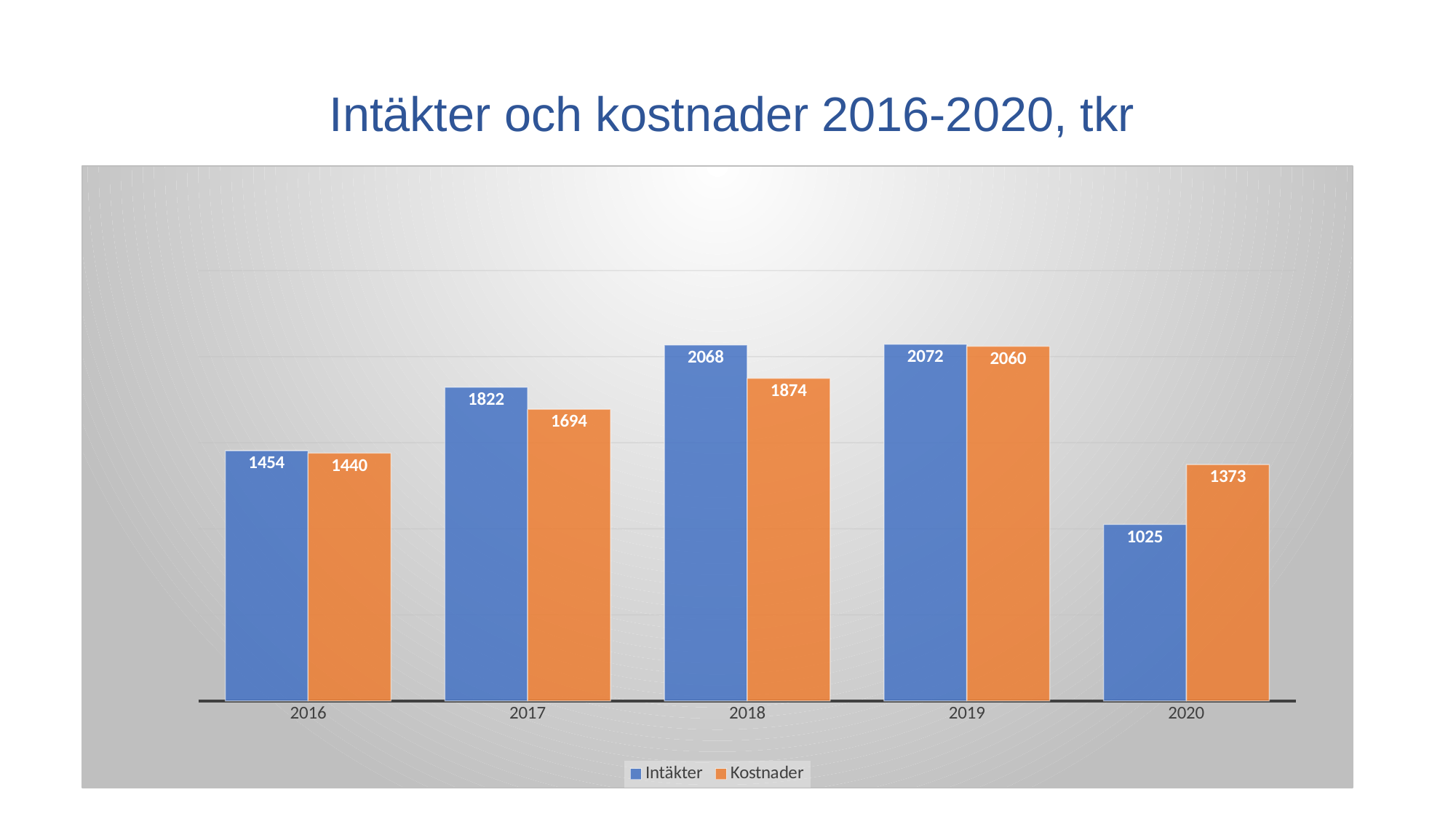
What is the value of Intäkter for 2018? 2068 What is the value of Kostnader for 2020? 1373 What is the title of the chart? Intäkter och kostnader 2016-2020, tkr What is the value of Kostnader for 2017? 1694 Which year has the lowest Kostnader value? 2020 What kind of chart is shown on the slide? Bar chart How many series does the legend list? 2 How many years are shown on the x axis? 5 In 2020, which is larger, Intäkter or Kostnader? Kostnader Which year has the highest Intäkter value? 2019 What is the difference between Intäkter in 2018 and Intäkter in 2016? 614 What is the difference between Intäkter and Kostnader in 2020? 348